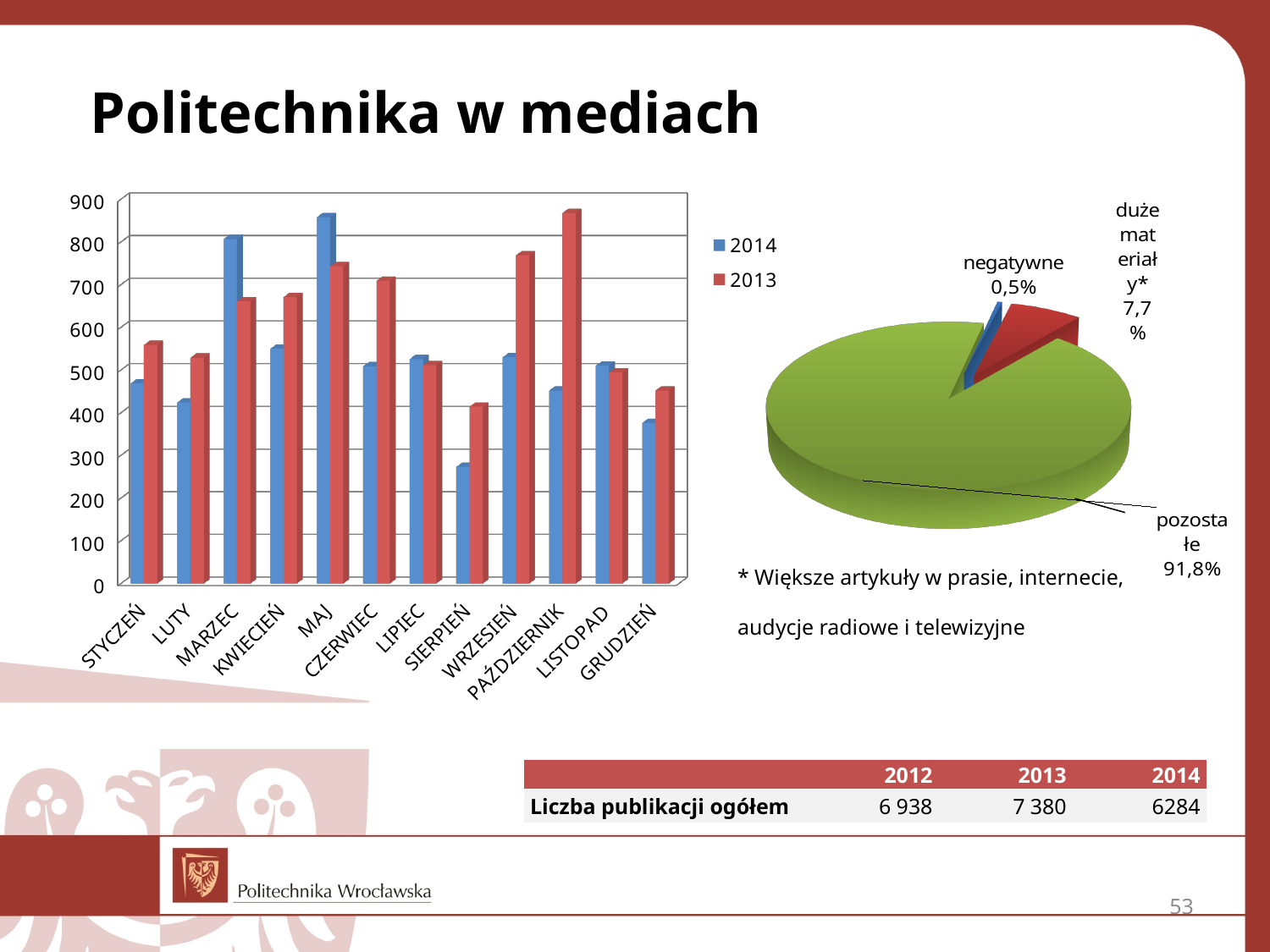
In the bar chart on the left, which month has the highest value for 2014? MAJ In the bar chart on the left, which month has the highest value for 2013? PAŹDZIERNIK In the bar chart on the left, is the 2013 value for PAŹDZIERNIK greater or less than 800? greater What kind of chart is the chart on the left of the slide? bar chart In the pie chart on the right, which slice is the largest? pozostałe In the bar chart on the left, how many months are shown on the x axis? 12 In the bar chart on the left, which month has the lowest value for 2014? SIERPIEŃ In the pie chart on the right, what share is labelled for 'negatywne'? 0,5% In the bar chart on the left, is the 2014 value for SIERPIEŃ greater or less than 300? less In the bar chart on the left, how many series does the legend list? 2 In the bar chart on the left, for MARZEC, which series has the larger value, 2014 or 2013? 2014 In the pie chart on the right, what share is labelled for 'pozostałe'? 91,8%